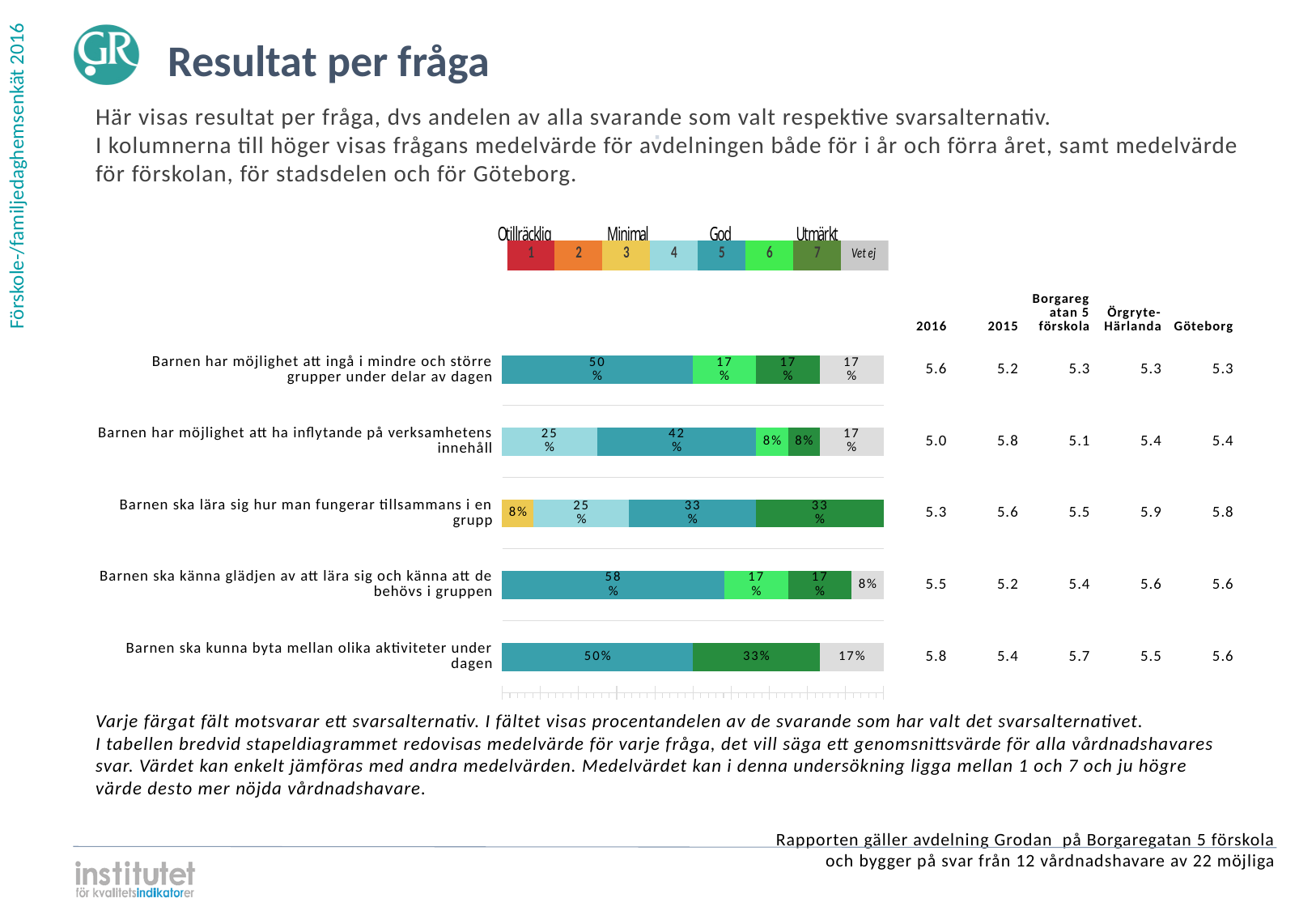
What percentage chose option 4 for 'Barnen har möjlighet att ha inflytande på verksamhetens innehåll'? 25% How many questions (categories) are shown in the bar chart? 5 What percentage chose 'Vet ej' for 'Barnen ska kunna byta mellan olika aktiviteter under dagen'? 17% What is the 2016 mean value for 'Barnen ska kunna byta mellan olika aktiviteter under dagen'? 5.8 Which is larger for 'Barnen har möjlighet att ha inflytande på verksamhetens innehåll': the share for option 4 or the share for option 5? Option 5 How many answer options does the legend above the chart list? 8 What type of chart is used to show the results per question? Stacked bar chart What label does the legend give to answer options 1 and 2? Otillräcklig Which question has the largest share of respondents choosing option 5 (God)? Barnen ska känna glädjen av att lära sig och känna att de behövs i gruppen What is the difference between the option 5 share and the option 7 share for 'Barnen ska kunna byta mellan olika aktiviteter under dagen'? 17% What percentage of respondents chose option 5 (God) for 'Barnen ska känna glädjen av att lära sig och känna att de behövs i gruppen'? 58% What percentage chose option 3 for 'Barnen ska lära sig hur man fungerar tillsammans i en grupp'? 8%